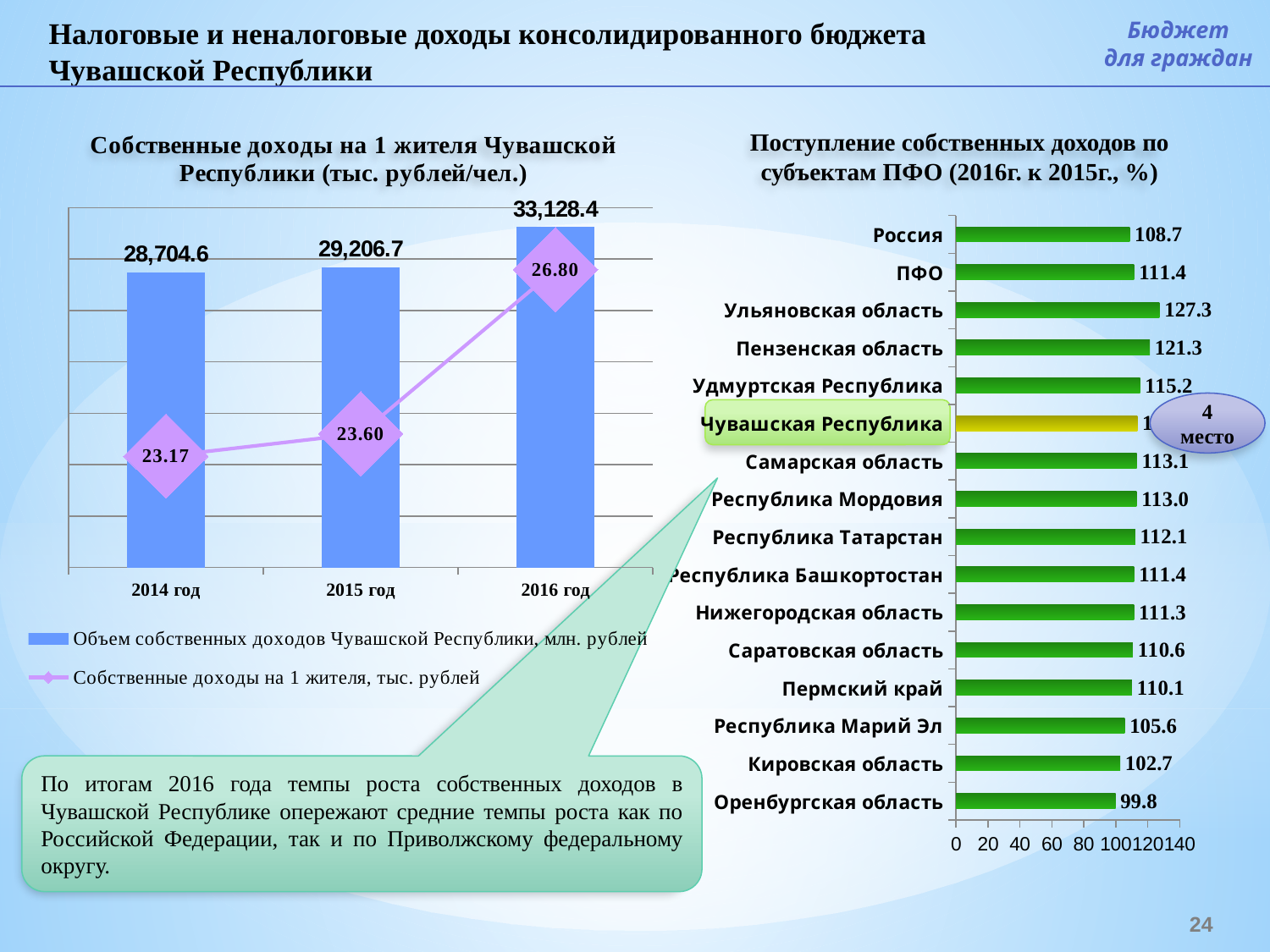
In the right chart 'Поступление собственных доходов по субъектам ПФО', what is the value for Ульяновская область? 127.3 What kind of chart is the right chart 'Поступление собственных доходов по субъектам ПФО'? bar chart In the right chart 'Поступление собственных доходов по субъектам ПФО', which is larger: the value for Пензенская область or the value for Удмуртская Республика? Пензенская область In the left chart 'Собственные доходы на 1 жителя Чувашской Республики', what is the value of the line marker for 2014 год? 23.17 In the left chart 'Собственные доходы на 1 жителя Чувашской Республики', how many series does the legend list? 2 In the left chart 'Собственные доходы на 1 жителя Чувашской Республики', what is the difference between the bar values for 2016 год and 2015 год? 3,921.7 In the right chart 'Поступление собственных доходов по субъектам ПФО', which region has the lowest value? Оренбургская область In the left chart 'Собственные доходы на 1 жителя Чувашской Республики', do the line values rise or fall from 2014 год to 2016 год? rise In the left chart 'Собственные доходы на 1 жителя Чувашской Республики', how many years are shown on the x axis? 3 In the left chart 'Собственные доходы на 1 жителя Чувашской Республики', what is the value of the bar for 2016 год? 33,128.4 In the right chart 'Поступление собственных доходов по субъектам ПФО', what is the difference between the values for ПФО and Россия? 2.7 In the right chart 'Поступление собственных доходов по субъектам ПФО', which region has the highest value? Ульяновская область